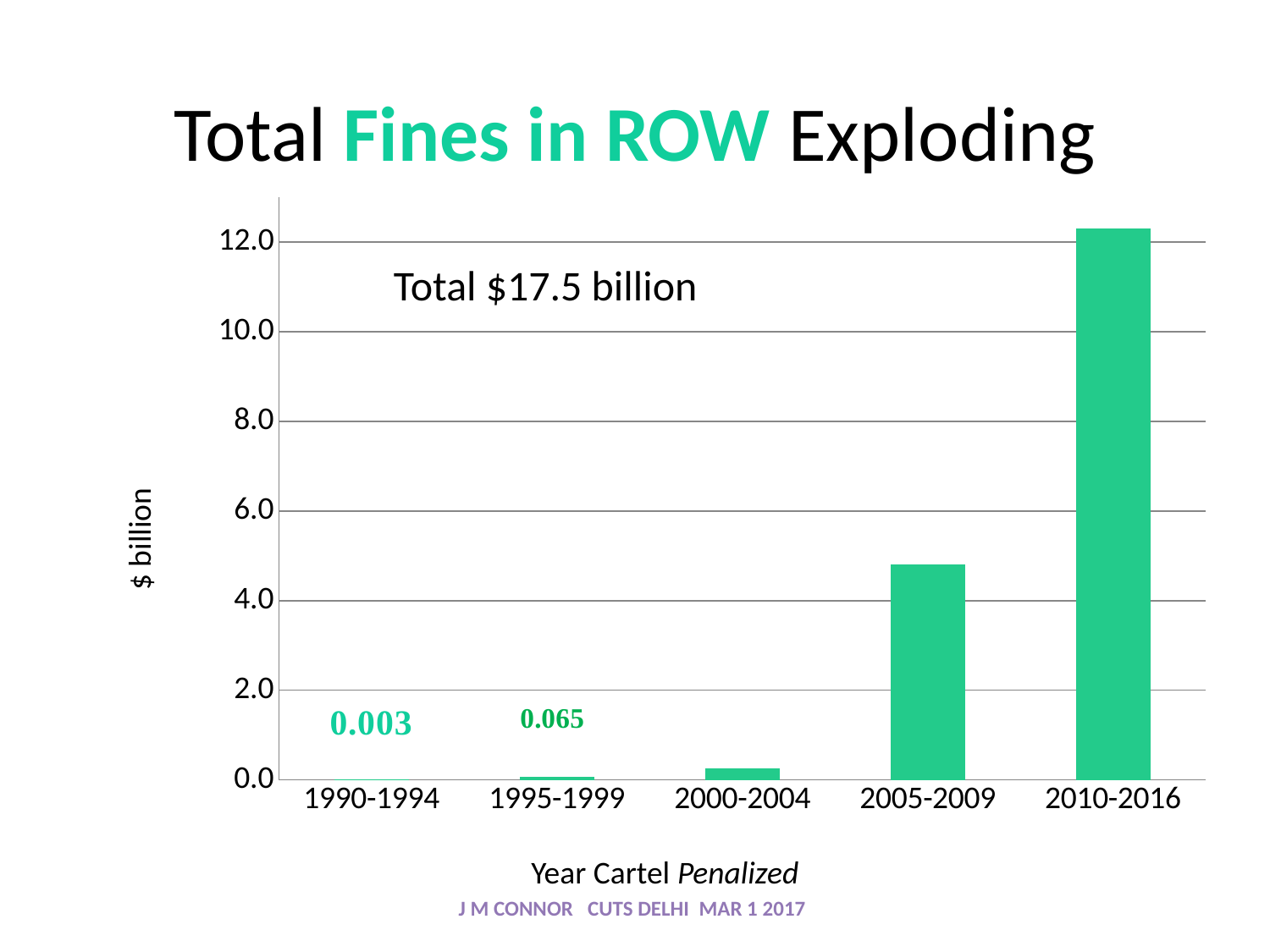
How many periods are shown on the x axis? 5 Which is larger, the value for 2005-2009 or the value for 2000-2004? 2005-2009 Which period has the highest total fines? 2010-2016 What is the value for 1990-1994? 0.003 What is the difference between the values for 1995-1999 and 1990-1994? 0.062 Do the values rise or fall from 1990-1994 to 2010-2016? rise Is the value for 2005-2009 greater or less than 4.0? greater What kind of chart is shown on the slide? bar chart Which period has the lowest total fines? 1990-1994 What is the value for 1995-1999? 0.065 Is the value for 2010-2016 greater or less than 12.0? greater Is the value for 2000-2004 greater or less than 2.0? less